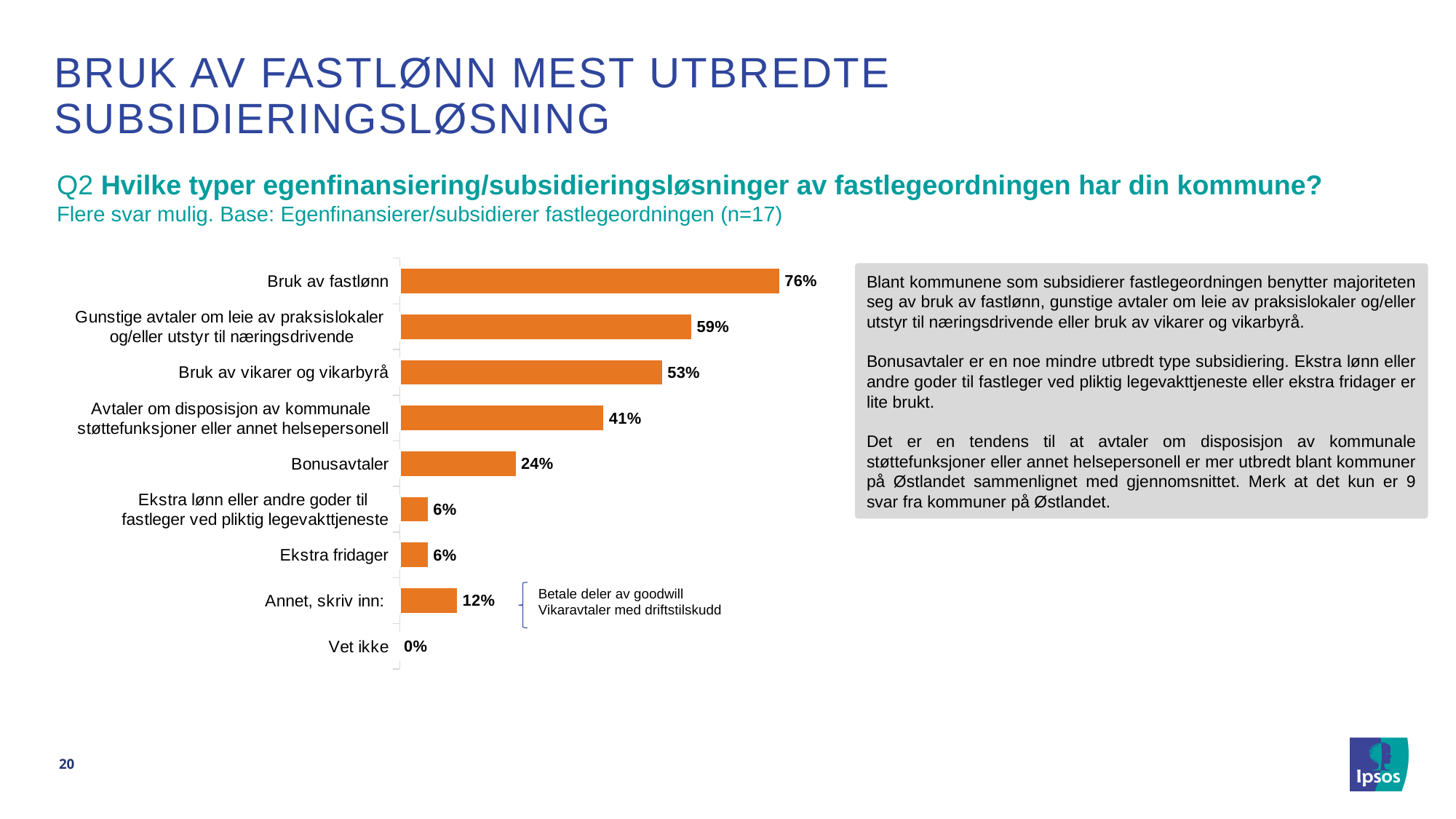
What is the value for "Bonusavtaler"? 24% How many categories are shown in the chart? 9 What kind of chart is shown on the slide? Bar chart What is the value for "Bruk av vikarer og vikarbyrå"? 53% What is the value for "Bruk av fastlønn"? 76% Which category has the lowest value? Vet ikke Which is larger: "Avtaler om disposisjon av kommunale støttefunksjoner eller annet helsepersonell" or "Bonusavtaler"? Avtaler om disposisjon av kommunale støttefunksjoner eller annet helsepersonell Which category has the highest value? Bruk av fastlønn What is the base size (n) stated for the chart? n=17 What is the difference between "Bruk av fastlønn" and "Gunstige avtaler om leie av praksislokaler og/eller utstyr til næringsdrivende"? 17 percentage points What is the value for "Annet, skriv inn:"? 12% What is the value for "Vet ikke"? 0%